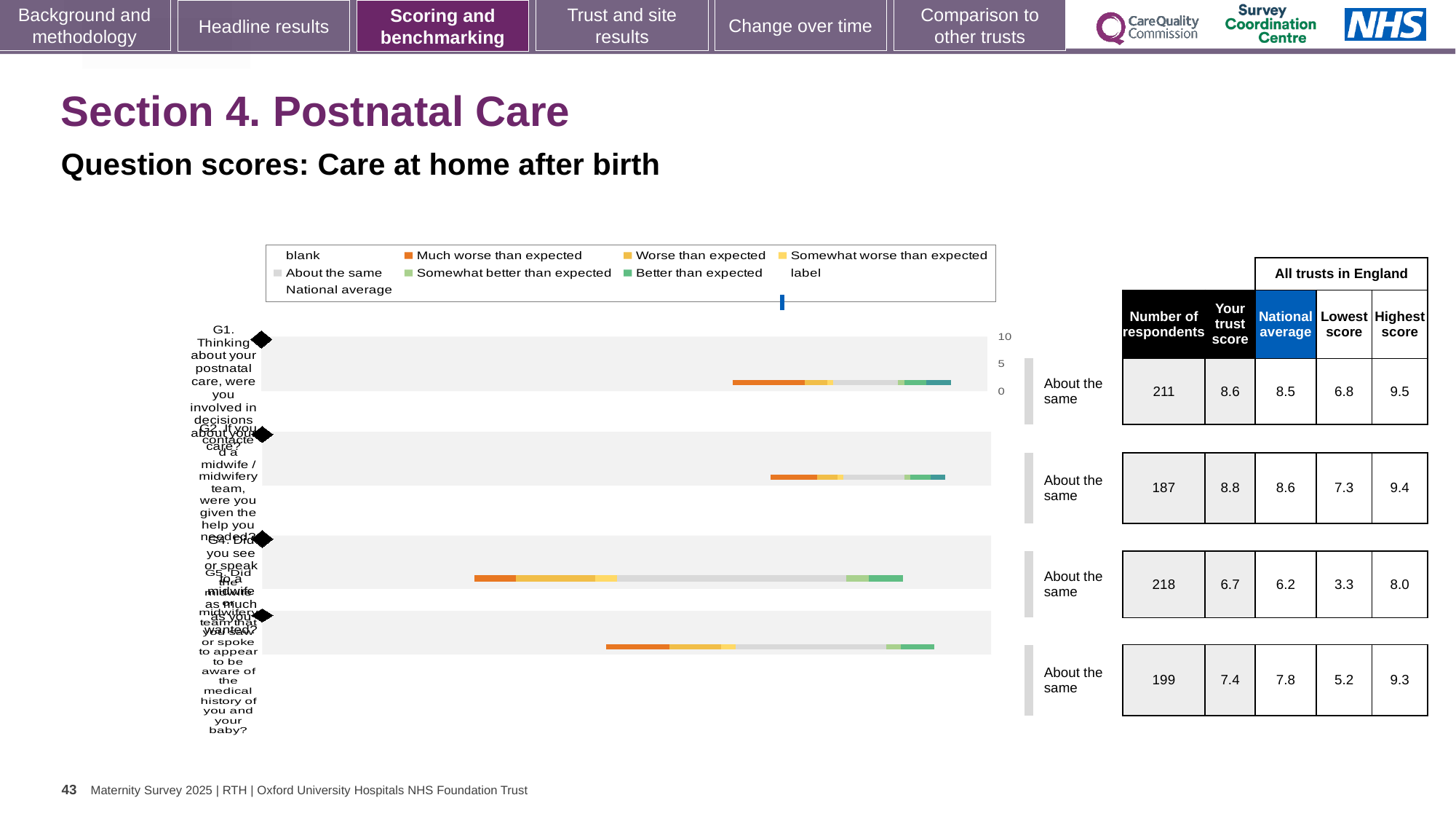
In the chart legend, which colour represents 'Much worse than expected'? orange What is the difference between the trust score and the national average in the first row (G1)? 0.1 How many question bars are plotted in the chart? 4 In the table next to the chart, what is the number of respondents for the first row (G1)? 211 Which table row has the lowest 'Lowest score' value? third row (G4), 3.3 What is the title of the slide's chart section? Question scores: Care at home after birth What kind of chart is shown on the slide? bar chart For the fourth row (G5), is the trust score or the national average larger? national average (7.8) Which table row has the highest number of respondents? third row (G4), 218 In the table next to the chart, what is the highest score for the fourth row (G5)? 9.3 In the table next to the chart, what is the trust score for the second row (G2)? 8.8 In the table next to the chart, what is the national average for the third row (G4)? 6.2